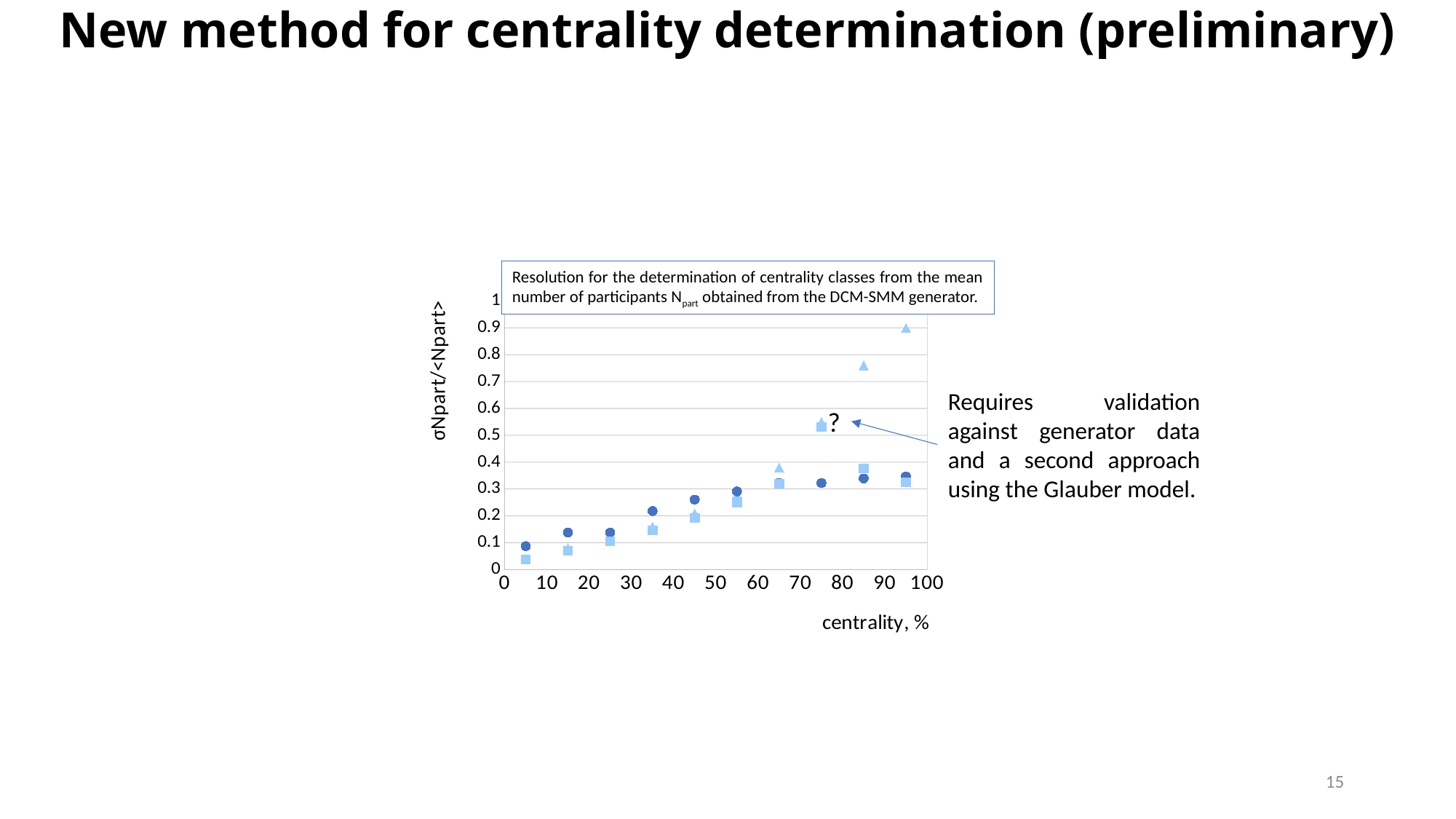
Is the value of the triangle marker at centrality 95 greater or less than 0.8? greater Is the value of the square marker at centrality 5 greater or less than 0.1? less Is the value of the circle marker at centrality 45 greater or less than 0.2? greater At centrality 95, which marker has the larger value, the triangle or the circle? triangle What kind of chart is shown on the slide? scatter chart What is the label of the x axis of the chart? centrality, % At which centrality value does the highest point on the chart occur? 95 How many circle-marker points are plotted on the chart? 10 What is the label of the y axis of the chart? σNpart/<Npart> Do the circle-marker values rise or fall as centrality increases from 5 to 95? rise